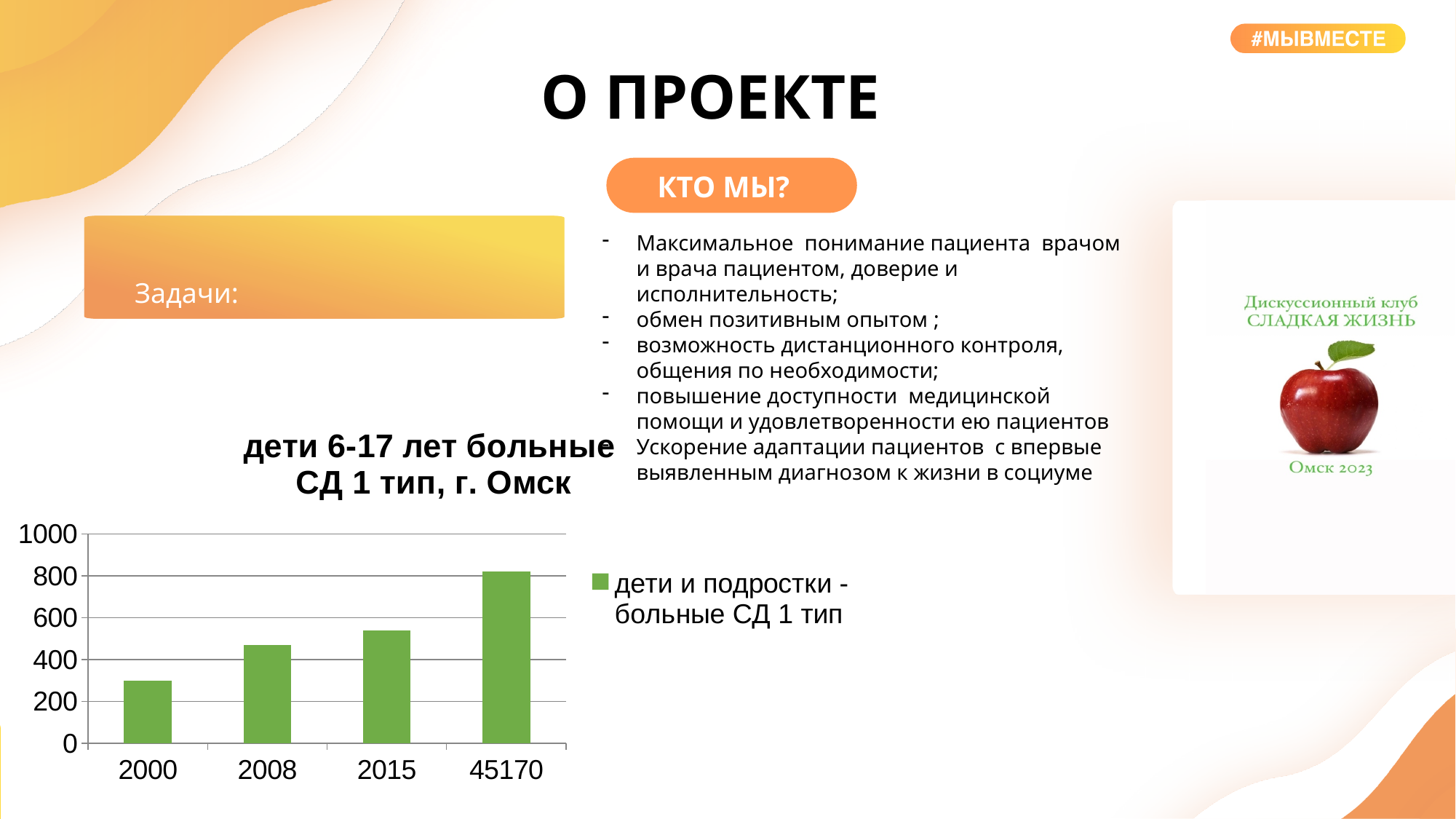
Is the value for 2000 greater or less than 400? less Which is larger, the value for 2008 or the value for 2015? 2015 What kind of chart is shown on the slide? bar chart Which category has the highest bar in the chart? 45170 Is the value for 45170 greater or less than 600? greater What is the legend entry of the chart? дети и подростки - больные СД 1 тип Which category has the lowest bar in the chart? 2000 Do the values rise or fall from left to right along the x axis? rise What is the title of the chart? дети 6-17 лет больные СД 1 тип, г. Омск How many series does the chart legend list? 1 Is the value for 2008 greater or less than 400? greater How many categories are shown on the x axis of the chart? 4